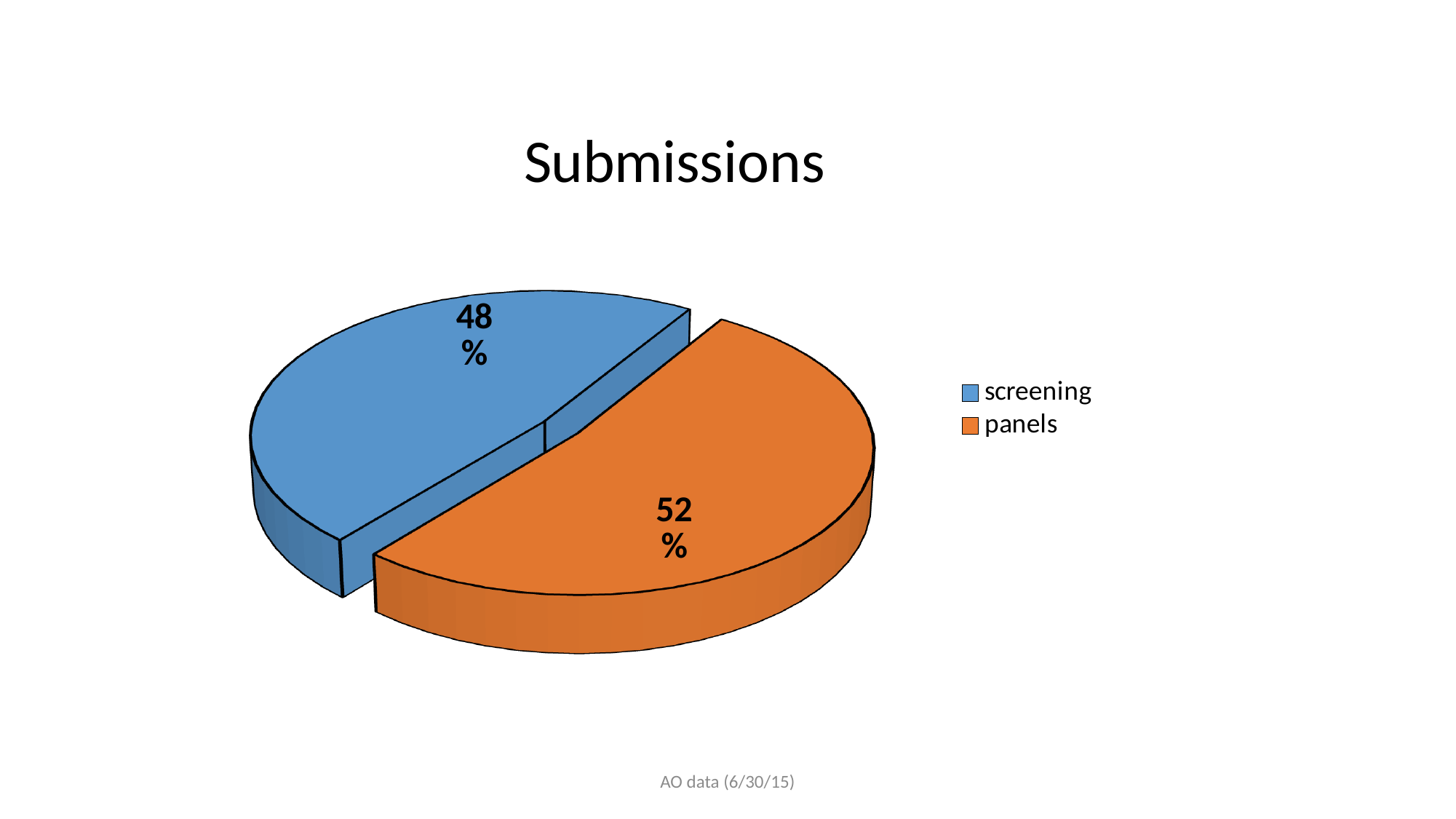
Which category has the larger share of the pie? panels Which category has the smaller share of the pie? screening What share of submissions is labelled as panels? 52% What is the difference in percentage points between the panels share and the screening share? 4 What share of submissions is labelled as screening? 48% What kind of chart is shown on the slide? pie chart How many entries does the legend list? 2 What is the title of the chart? Submissions How many slices does the pie chart have? 2 Is the share for screening greater or less than 50%? less Which colour represents the screening slice? blue Is the share for panels larger or smaller than the share for screening? larger